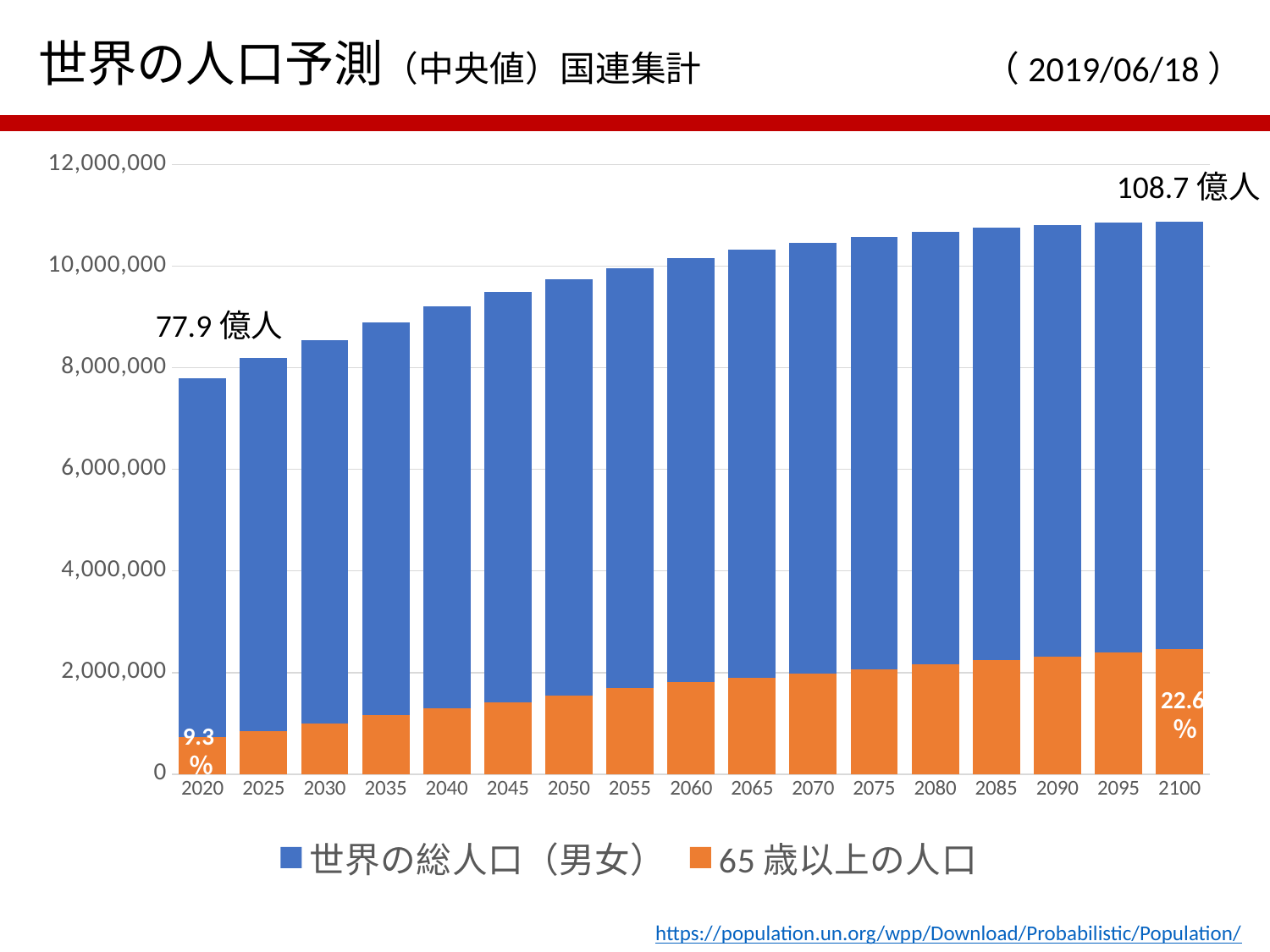
How many years (categories) are shown on the x axis? 17 What percentage label is shown on the 65歳以上の人口 bar for 2020? 9.3% Does the world total population rise or fall from 2020 to 2100? rise How many series does the legend list? 2 What percentage label is shown on the 65歳以上の人口 bar for 2100? 22.6% What is the labelled world total population for 2020? 77.9 億人 Is the 65歳以上の人口 value for 2060 greater or less than 2,000,000? less What kind of chart is shown on the slide? bar chart Which year has the lowest 65歳以上の人口 value in the chart? 2020 Which year has the highest world total population in the chart? 2100 What is the labelled world total population for 2100? 108.7 億人 Is the world total population for 2050 greater or less than 8,000,000? greater